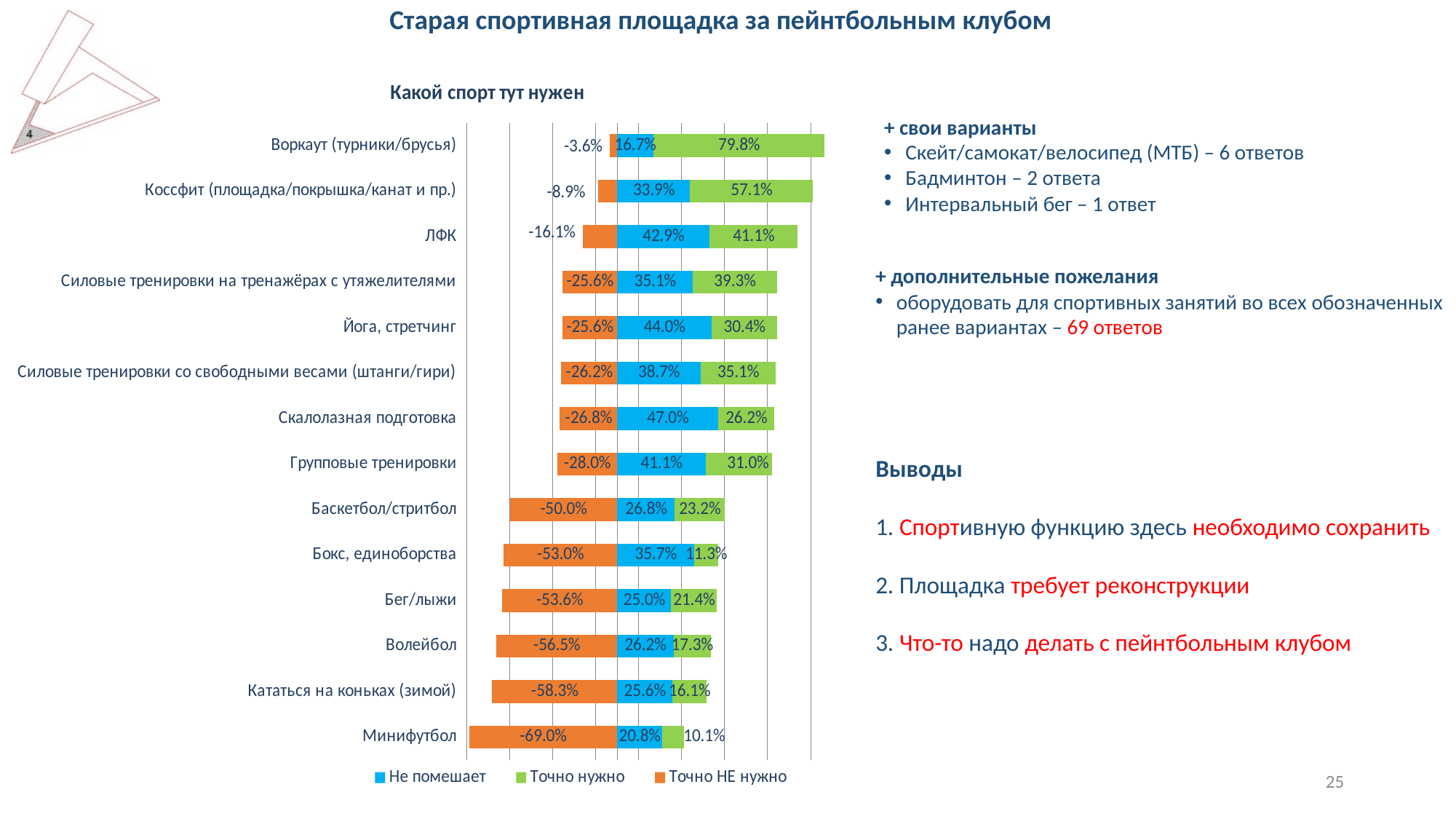
Which category has the highest "Точно нужно" value? Воркаут (турники/брусья) What is the "Точно НЕ нужно" value for Минифутбол? -69.0% Which category has the lowest "Точно нужно" value? Минифутбол Which has a larger "Не помешает" value: Йога, стретчинг or Бег/лыжи? Йога, стретчинг How many categories are shown in the chart? 14 What is the "Точно нужно" value for Коссфит (площадка/покрышка/канат и пр.)? 57.1% What kind of chart is shown on the slide? Stacked bar chart What is the "Точно нужно" value for Воркаут (турники/брусья)? 79.8% What is the "Не помешает" value for Скалолазная подготовка? 47.0% Which colour represents the "Точно НЕ нужно" series in the chart? Orange What is the difference between the "Точно нужно" values for Воркаут (турники/брусья) and Коссфит (площадка/покрышка/канат и пр.)? 22.7% How many series does the legend list? 3